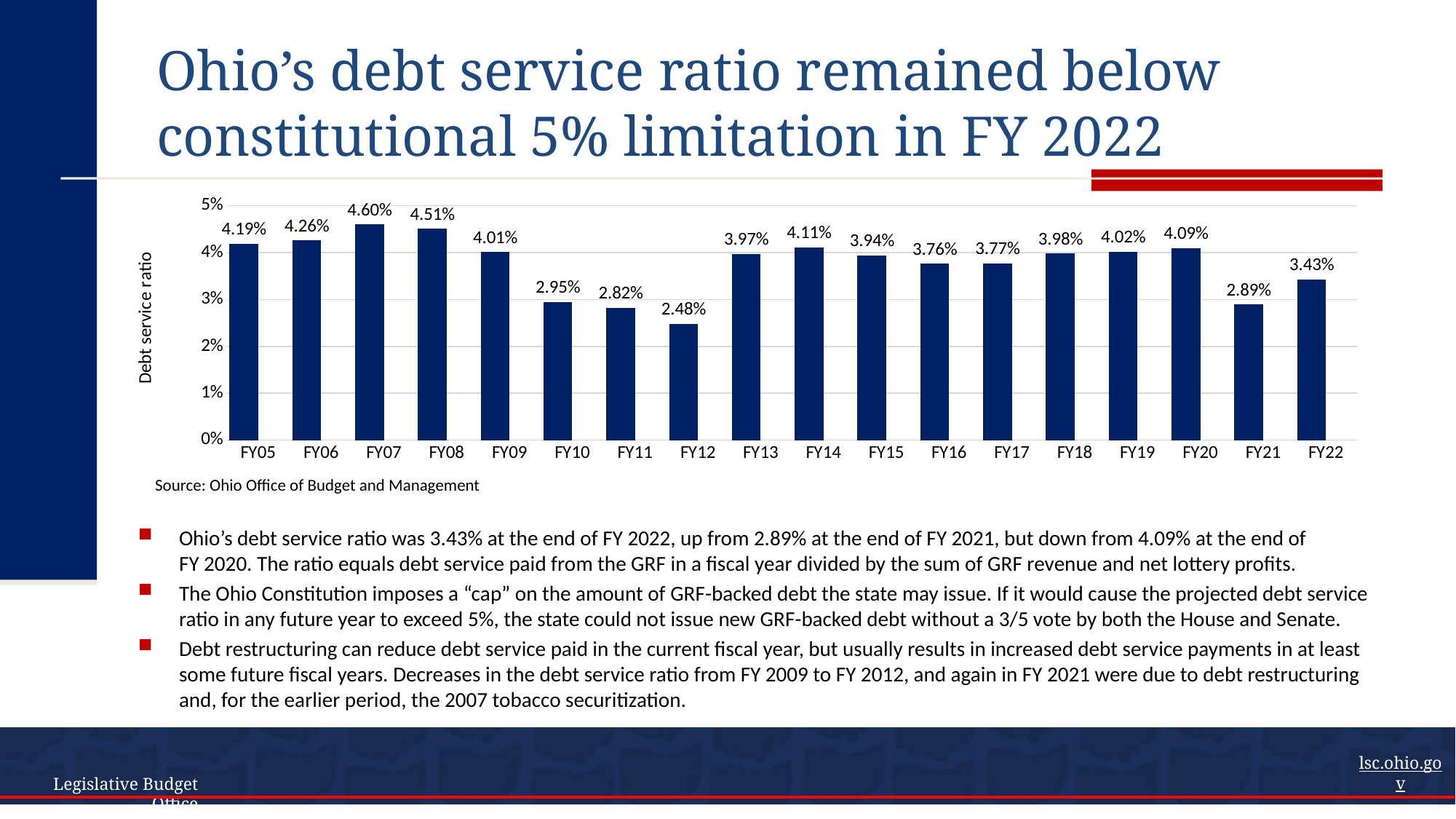
What is the label on the vertical axis of the chart? Debt service ratio Which fiscal year had the lowest debt service ratio? FY12 What was the debt service ratio in FY07? 4.60% Did the debt service ratio rise or fall from FY08 to FY12? Fall What kind of chart is shown on the slide? Bar chart Which year had a higher debt service ratio, FY20 or FY21? FY20 Is the debt service ratio for FY10 greater or less than 3%? less Which fiscal year had the highest debt service ratio? FY07 How many fiscal years are shown on the chart? 18 By how many percentage points did the debt service ratio change from FY21 to FY22? 0.54 percentage points What was Ohio's debt service ratio in FY22? 3.43% What was the debt service ratio in FY12? 2.48%